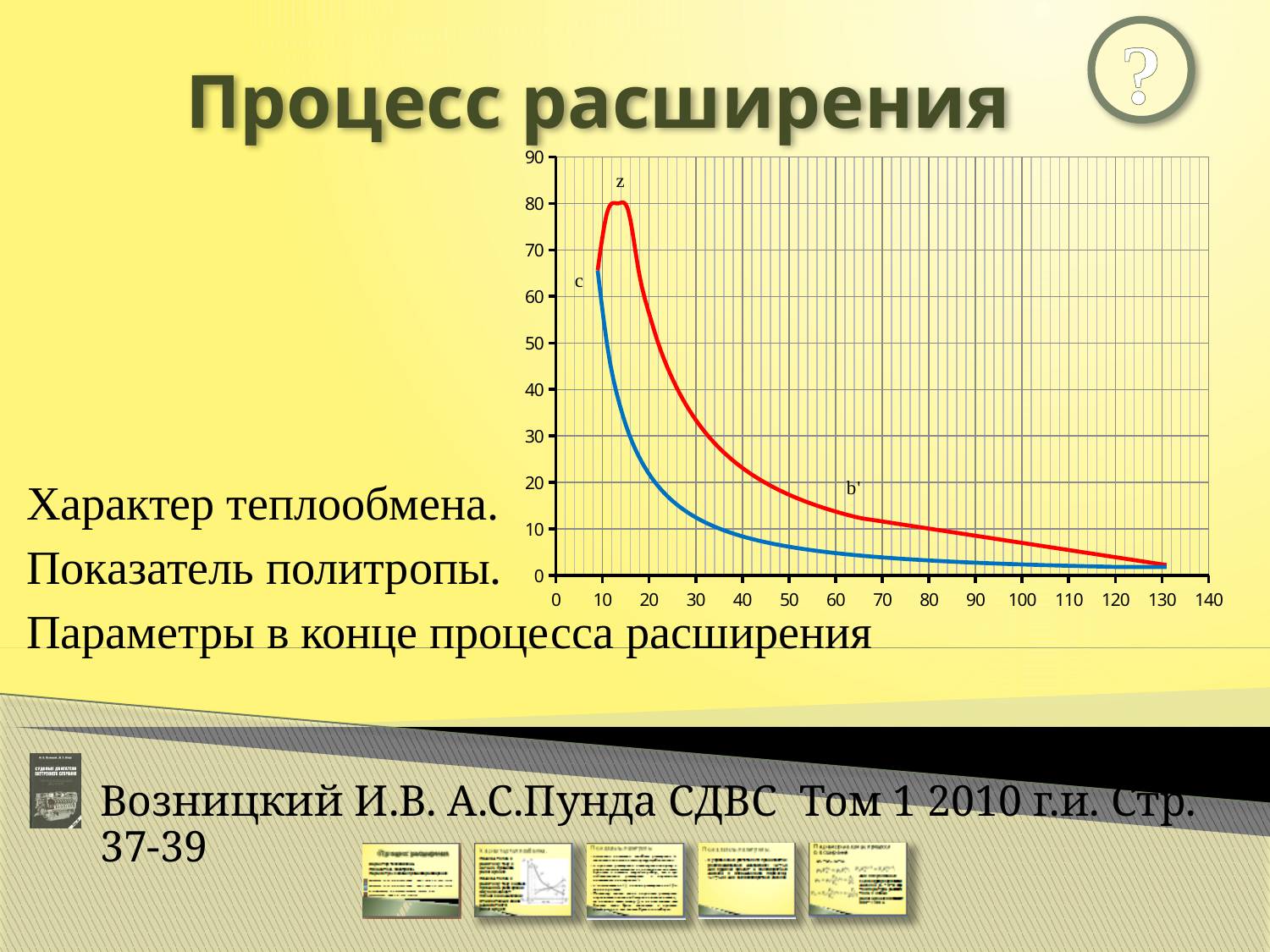
What kind of chart is shown on the slide? line chart After its peak at point z, does the red curve rise or fall as x increases? fall What colours are the two curves on the chart? red and blue What is the highest value shown on the vertical axis? 90 Is the peak value of the red curve (at point z) greater or less than 70? greater Is the value of the red curve at x = 100 greater or less than 10? less What is the highest value shown on the horizontal axis? 140 How many curves are plotted on the chart? 2 Is the value of the blue curve at x = 30 greater or less than 20? less At x = 50, which curve has the larger value, the red or the blue? red Does the blue curve rise or fall as x increases? fall What are the three point labels written on the chart? c, z, b'